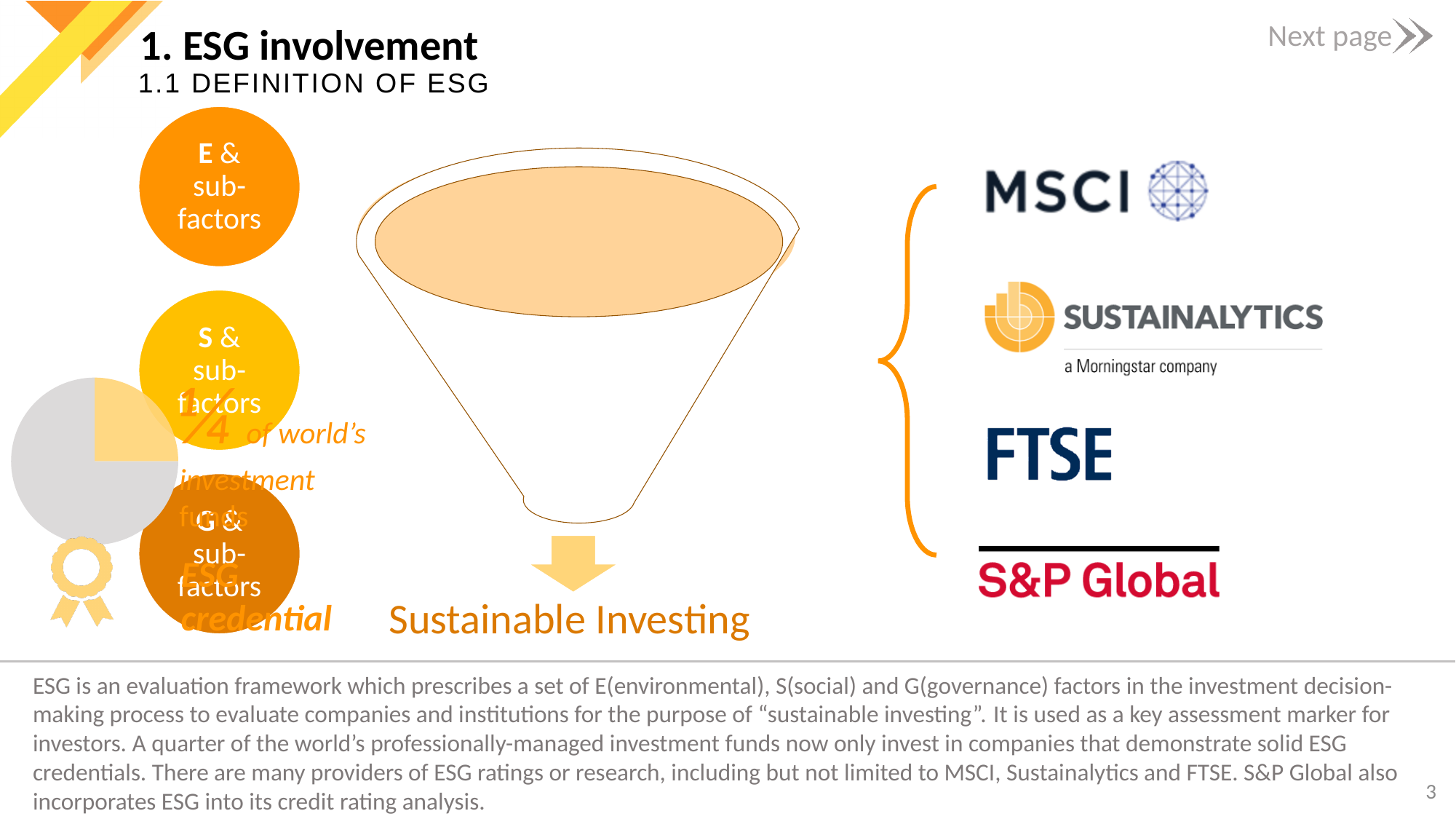
How many slices does the pie chart on the left of the slide have? 2 What share of the pie chart on the left is highlighted in yellow, according to the label next to it? 1/4 According to the label beside the pie chart, the highlighted quarter represents what share of the world's investment funds? 1/4 In the pie chart on the left, which slice is larger: the grey slice or the yellow slice? the grey slice What colour is the smaller slice of the pie chart on the left of the slide? yellow What kind of chart is shown on the left side of the slide? pie chart